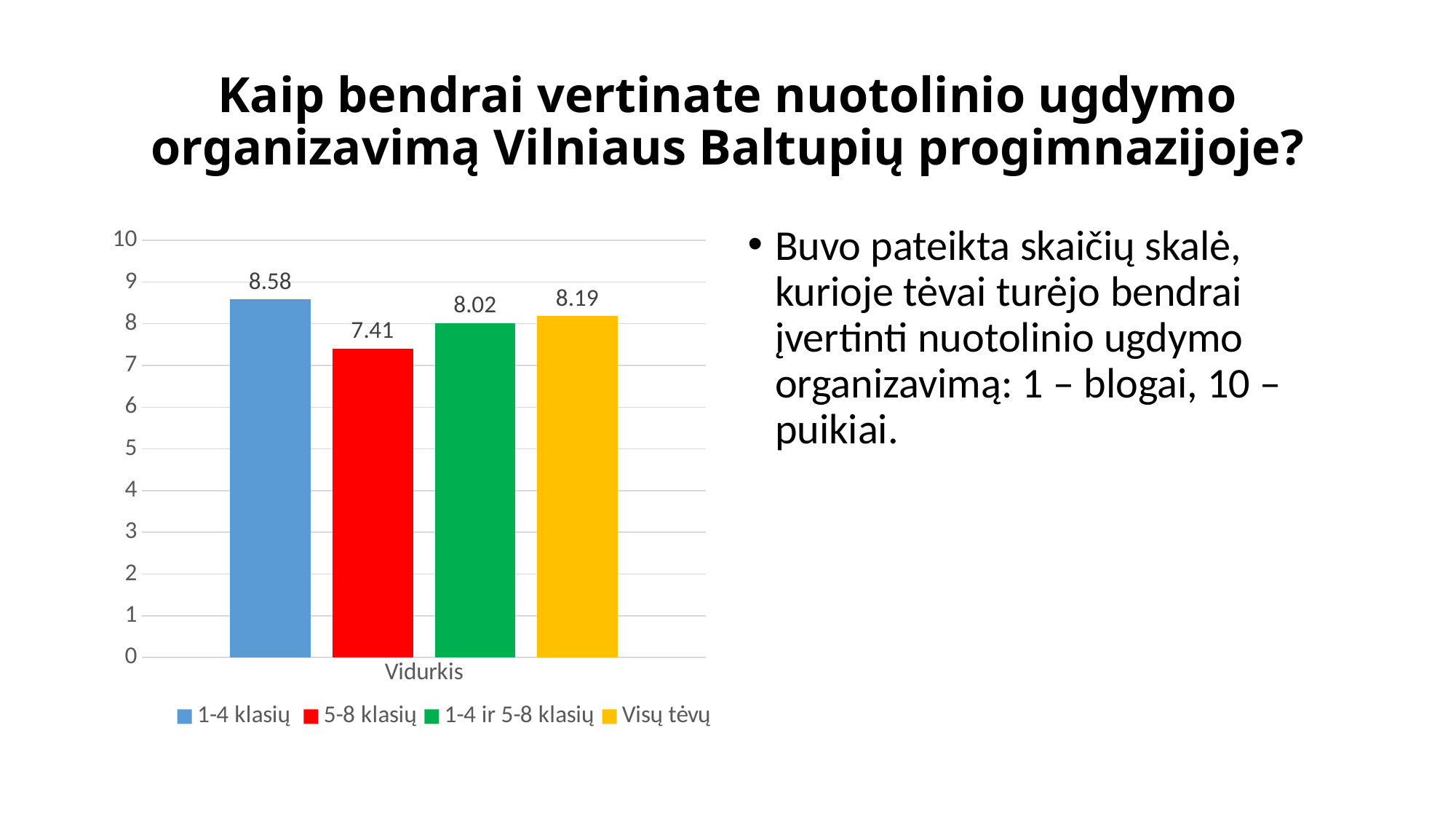
How many series does the legend list? 4 What is the value for the Visų tėvų series? 8.19 What is the category label on the x axis of the chart? Vidurkis What kind of chart is shown on the slide? bar chart What is the value for the 1-4 klasių series? 8.58 What is the value for the 1-4 ir 5-8 klasių series? 8.02 Which is larger, the value for Visų tėvų or the value for 1-4 ir 5-8 klasių? Visų tėvų Which series has the highest value? 1-4 klasių What is the difference between the 1-4 klasių value and the 5-8 klasių value? 1.17 What is the value for the 5-8 klasių series? 7.41 Which series has the lowest value? 5-8 klasių Is the value for 5-8 klasių greater or less than 8? less